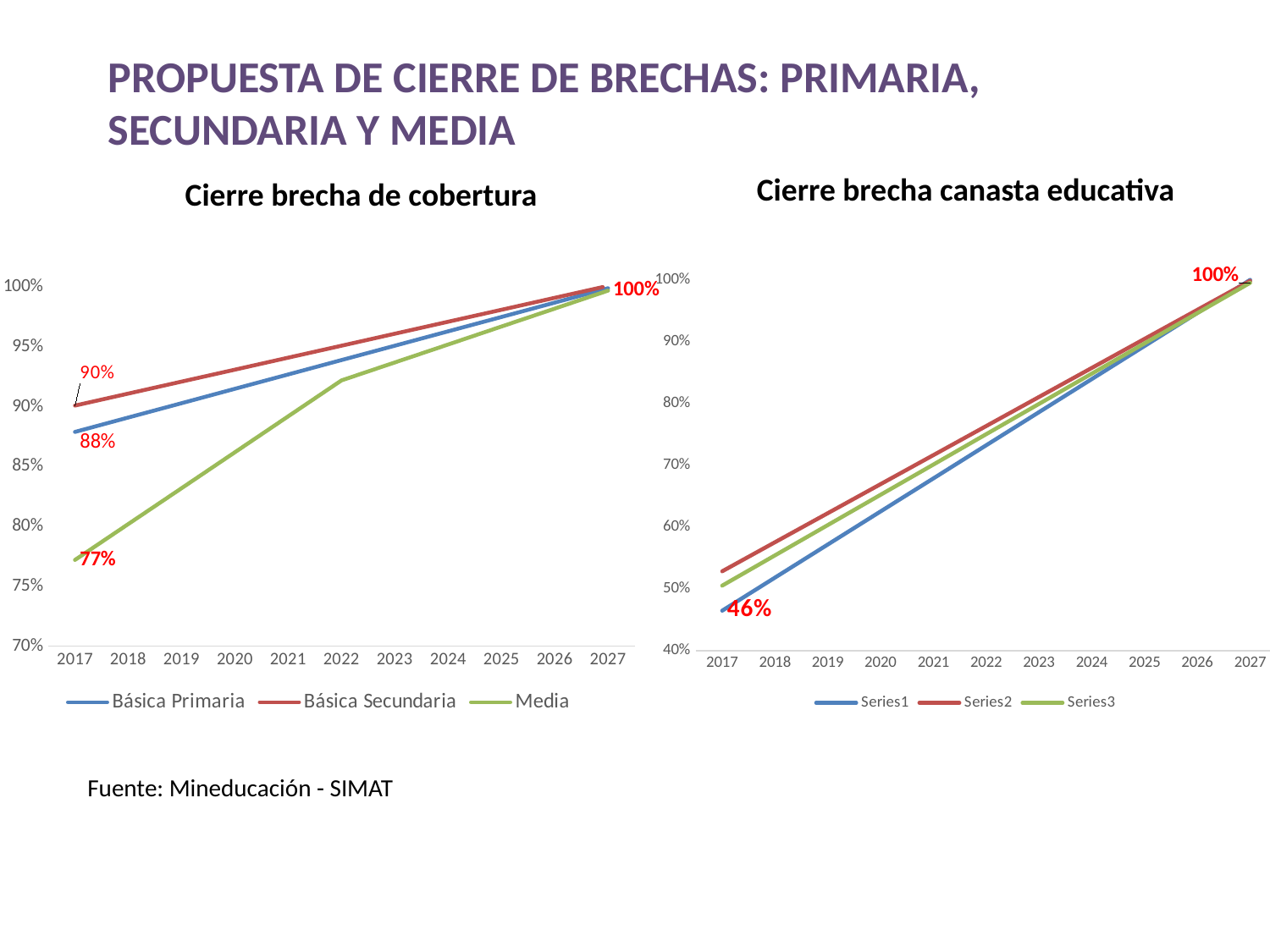
In the 'Cierre brecha de cobertura' chart, what is the difference between the Básica Secundaria and Media values in 2017? 13% In the 'Cierre brecha de cobertura' chart, what is the value for Básica Secundaria in 2017? 90% In the 'Cierre brecha de cobertura' chart, is the value for Media in 2022 greater or less than 90%? greater In the 'Cierre brecha canasta educativa' chart, what is the value for Series1 in 2017? 46% In the 'Cierre brecha canasta educativa' chart, what value do the series reach in 2027? 100% In the 'Cierre brecha de cobertura' chart, what is the value for Básica Primaria in 2017? 88% In the 'Cierre brecha canasta educativa' chart, do the values rise or fall from 2017 to 2027? rise In the 'Cierre brecha de cobertura' chart, which series has the lowest value in 2017? Media In the 'Cierre brecha de cobertura' chart, how many series does the legend list? 3 What kind of chart is the 'Cierre brecha canasta educativa' chart? line chart In the 'Cierre brecha canasta educativa' chart, is the value for Series2 in 2017 greater or less than 50%? greater In the 'Cierre brecha de cobertura' chart, what is the value for Media in 2017? 77%